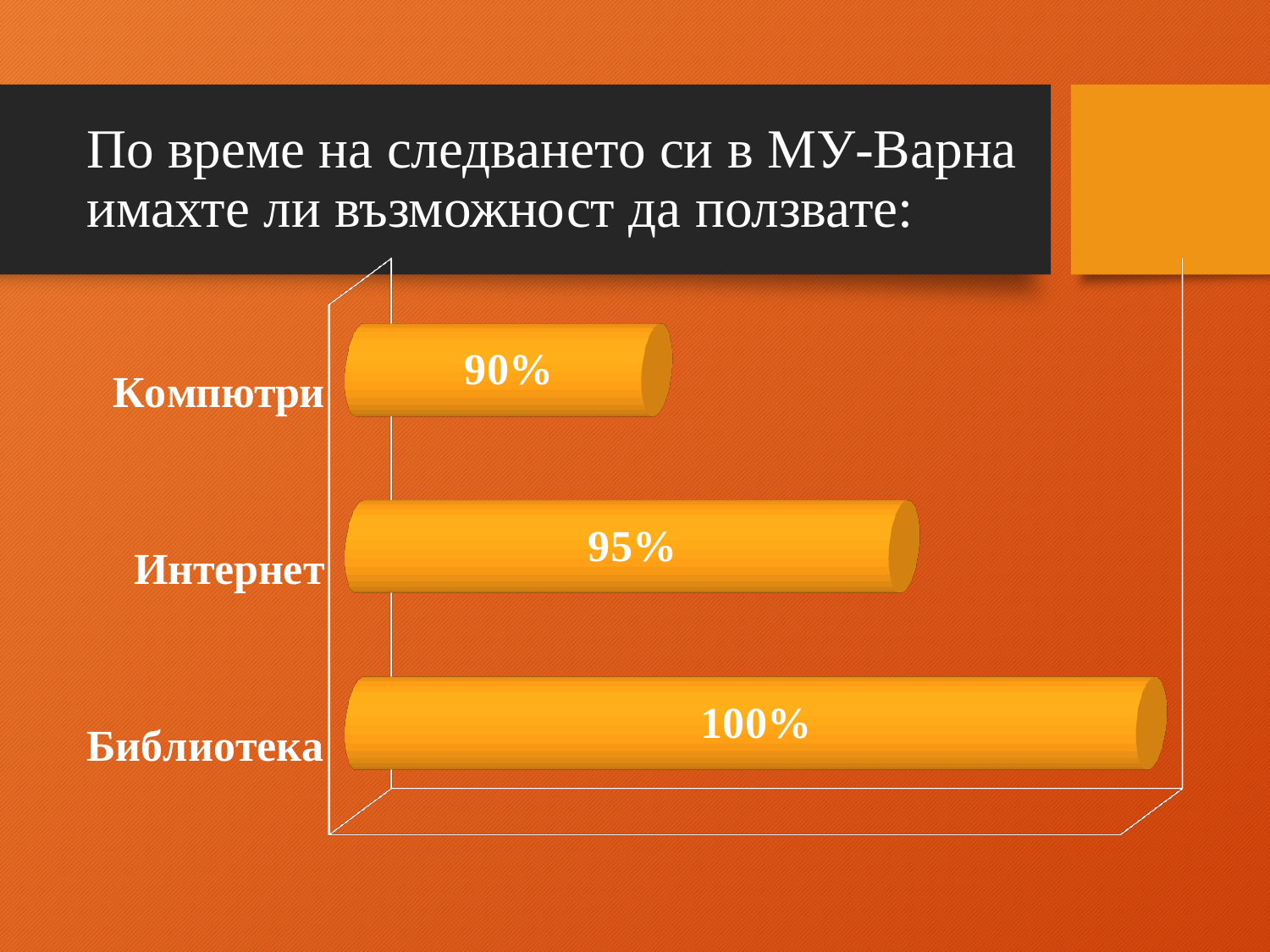
What colour are the bars in the chart? orange What is the value for Компютри? 90% Which category has the highest value? Библиотека Are the bars in the chart horizontal or vertical? horizontal Which is larger, the value for Интернет or the value for Компютри? Интернет What is the value for Интернет? 95% What is the value for Библиотека? 100% What is the difference between the values for Библиотека and Компютри? 10% What is the difference between the values for Интернет and Компютри? 5% Which category has the lowest value? Компютри What kind of chart is shown on the slide? bar chart How many categories are shown in the chart? 3